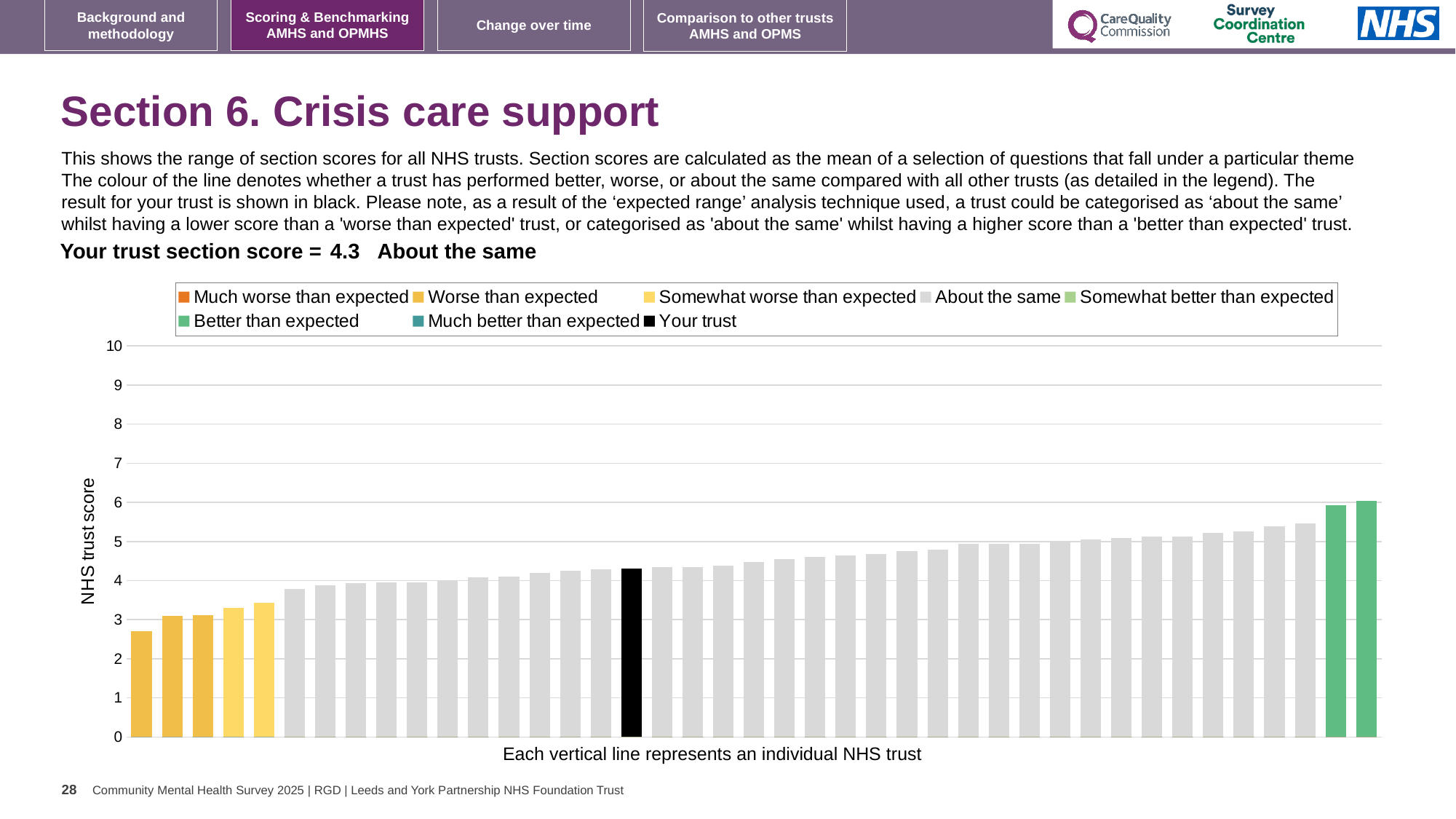
Which is larger: the value for your trust (black bar) or the value of the leftmost bar? your trust What kind of chart is shown on the slide? bar chart How many bars are coloured as 'Worse than expected' (darker yellow)? 3 What is the label on the y axis of the chart? NHS trust score What is the section score for your trust (the black bar)? 4.3 How many bars are coloured as 'Better than expected' (green)? 2 Is the value of the rightmost (highest) bar greater or less than 5? greater How many entries does the chart legend list? 8 What colour is used for 'Your trust' in the chart? black Is the value of the leftmost (lowest) bar greater or less than 3? less Do the bar values rise or fall from left to right along the x axis? rise Is the value for your trust (the black bar) greater or less than 4? greater